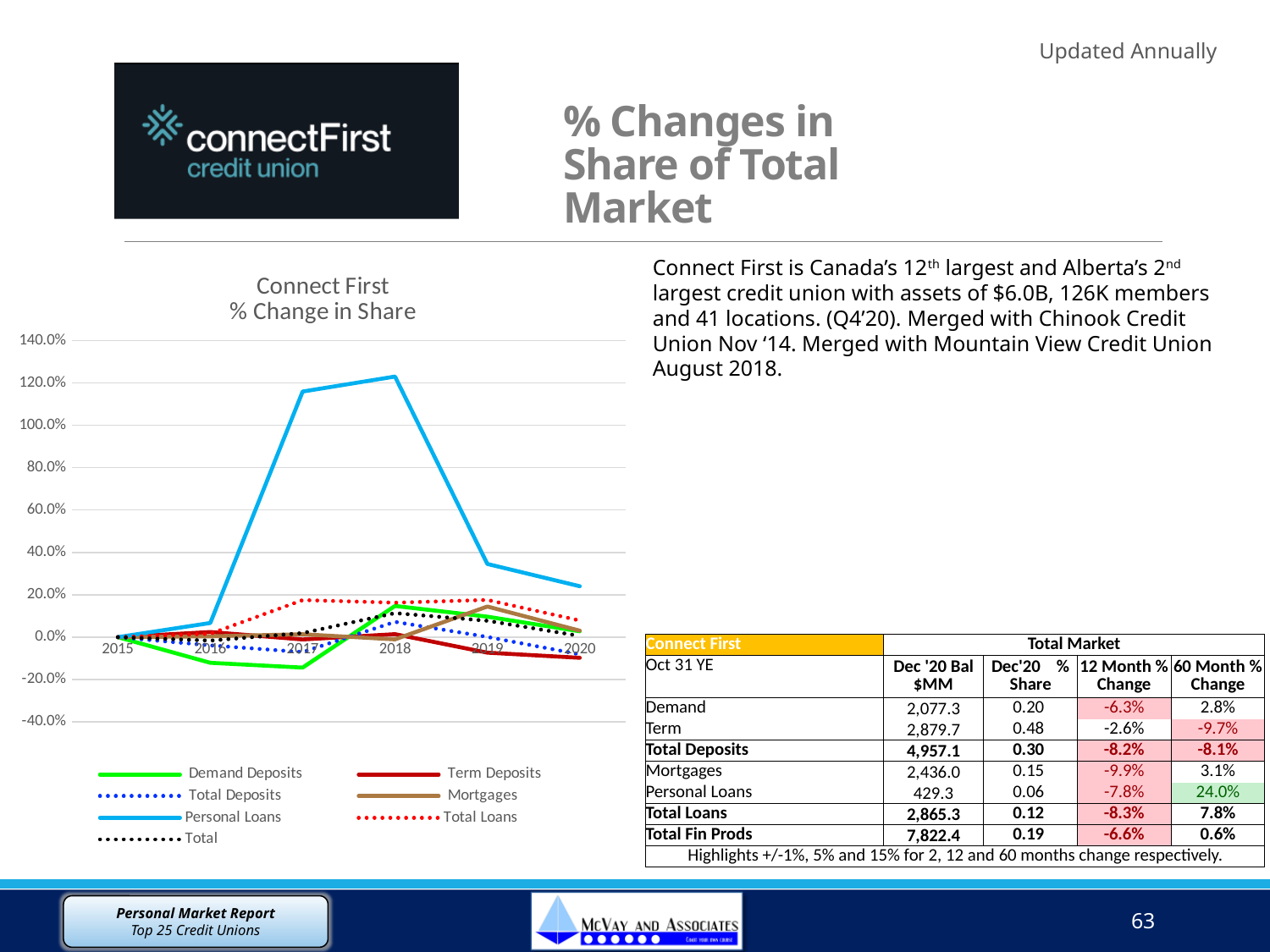
What is the first year shown on the x axis of the "Connect First % Change in Share" chart? 2015 What kind of chart is the "Connect First % Change in Share" chart? line chart In the "Connect First % Change in Share" chart, is the value for Personal Loans in 2017 greater or less than 100.0%? greater In the "Connect First % Change in Share" chart, is the value for Demand Deposits in 2017 greater or less than 0.0%? less In the "Connect First % Change in Share" chart, which series has the lowest value in 2017? Demand Deposits In the "Connect First % Change in Share" chart, is the value for Personal Loans in 2019 greater or less than 40.0%? less What is the highest value shown on the y axis of the "Connect First % Change in Share" chart? 140.0% In the "Connect First % Change in Share" chart, does the Personal Loans line rise or fall from 2018 to 2020? fall How many series does the legend of the "Connect First % Change in Share" chart list? 7 In the "Connect First % Change in Share" chart, which series has the highest value in 2018? Personal Loans In the "Connect First % Change in Share" chart, which is larger in 2018: Personal Loans or Demand Deposits? Personal Loans How many years are shown on the x axis of the "Connect First % Change in Share" chart? 6